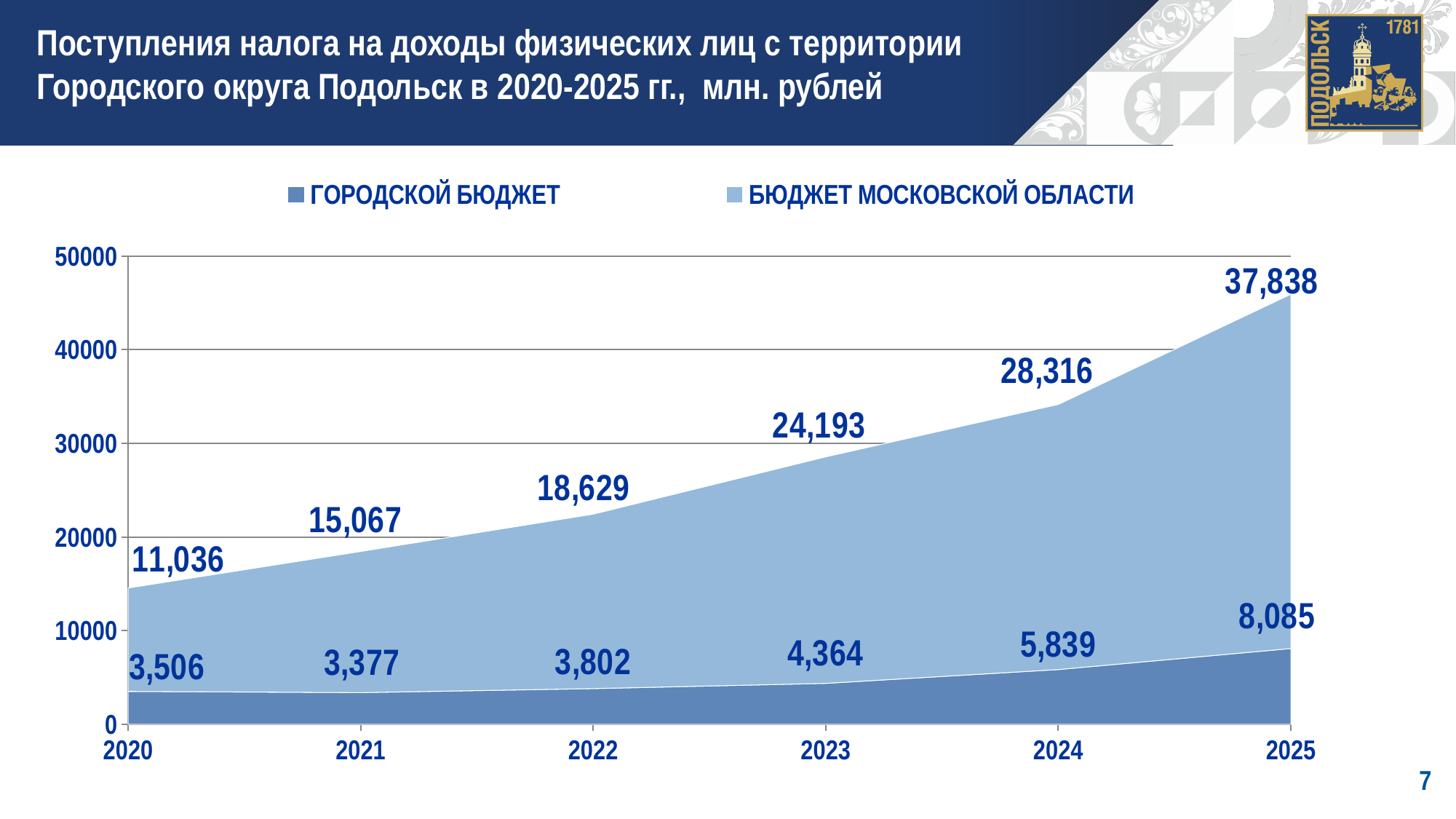
How many years are shown on the x axis? 6 What is the value for ГОРОДСКОЙ БЮДЖЕТ in 2021? 3,377 In which year is the value for БЮДЖЕТ МОСКОВСКОЙ ОБЛАСТИ the highest? 2025 What is the combined total of ГОРОДСКОЙ БЮДЖЕТ and БЮДЖЕТ МОСКОВСКОЙ ОБЛАСТИ for 2020? 14,542 Which is larger: the ГОРОДСКОЙ БЮДЖЕТ value for 2023 or for 2024? 2024 What is the difference between the БЮДЖЕТ МОСКОВСКОЙ ОБЛАСТИ values for 2025 and 2024? 9,522 What is the value for БЮДЖЕТ МОСКОВСКОЙ ОБЛАСТИ in 2022? 18,629 How many series does the legend list? 2 In which year is the value for ГОРОДСКОЙ БЮДЖЕТ the lowest? 2021 What kind of chart is shown on the slide? Stacked area chart Does the value for БЮДЖЕТ МОСКОВСКОЙ ОБЛАСТИ rise or fall from 2020 to 2025? Rise What is the value for ГОРОДСКОЙ БЮДЖЕТ in 2025? 8,085